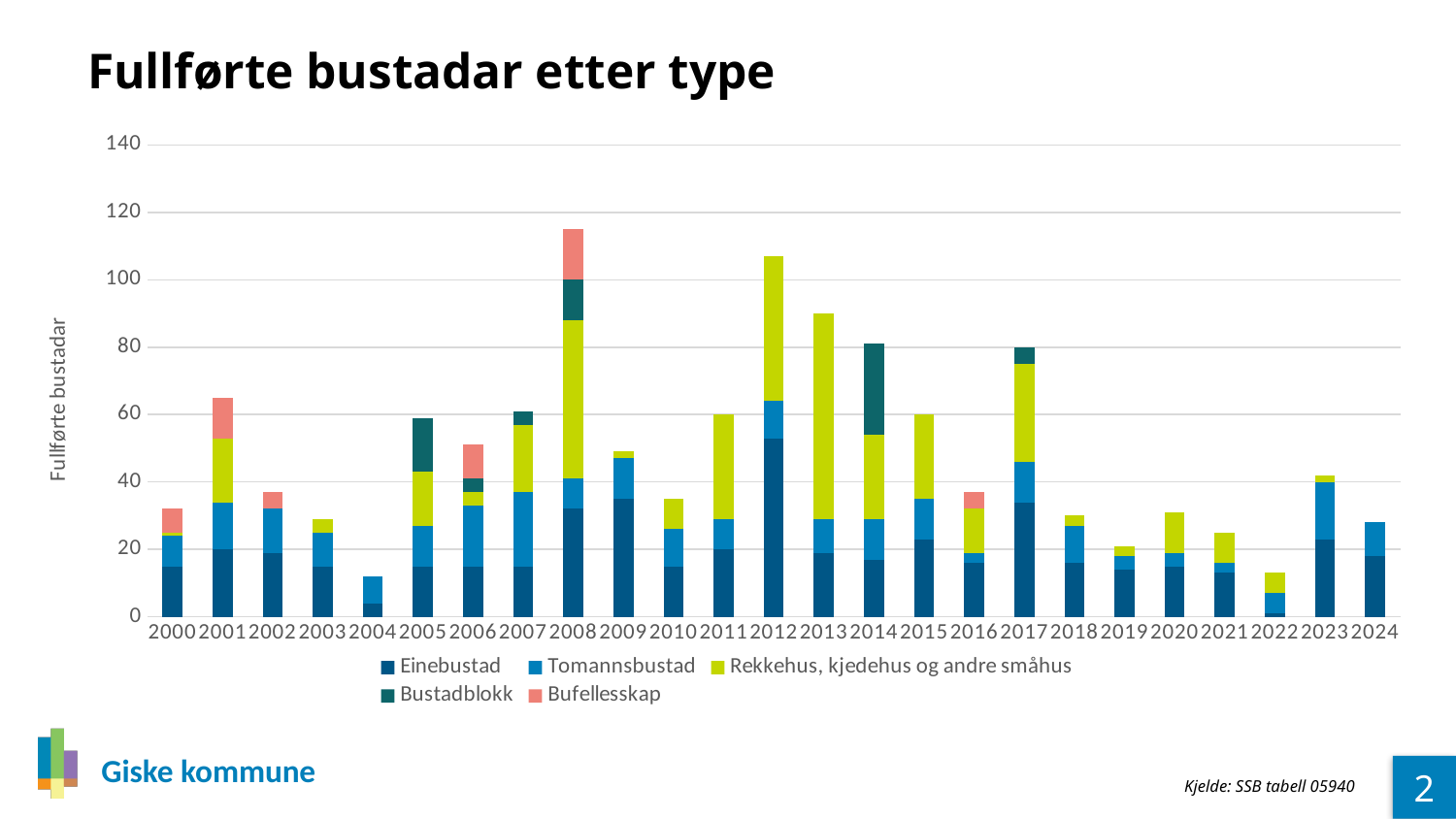
Do the total values rise or fall from 2012 to 2016? fall What is the title of the chart? Fullførte bustadar etter type How many years are shown along the x axis? 25 Is the total value for 2013 greater or less than 80? greater Which year has the highest total of completed dwellings? 2008 Which year has the larger total, 2001 or 2002? 2001 How many series does the legend list? 5 Which year has the larger total, 2012 or 2013? 2012 Is the total value for 2008 greater or less than 100? greater Is the total value for 2024 greater or less than 40? less What kind of chart is shown on the slide? Stacked bar chart